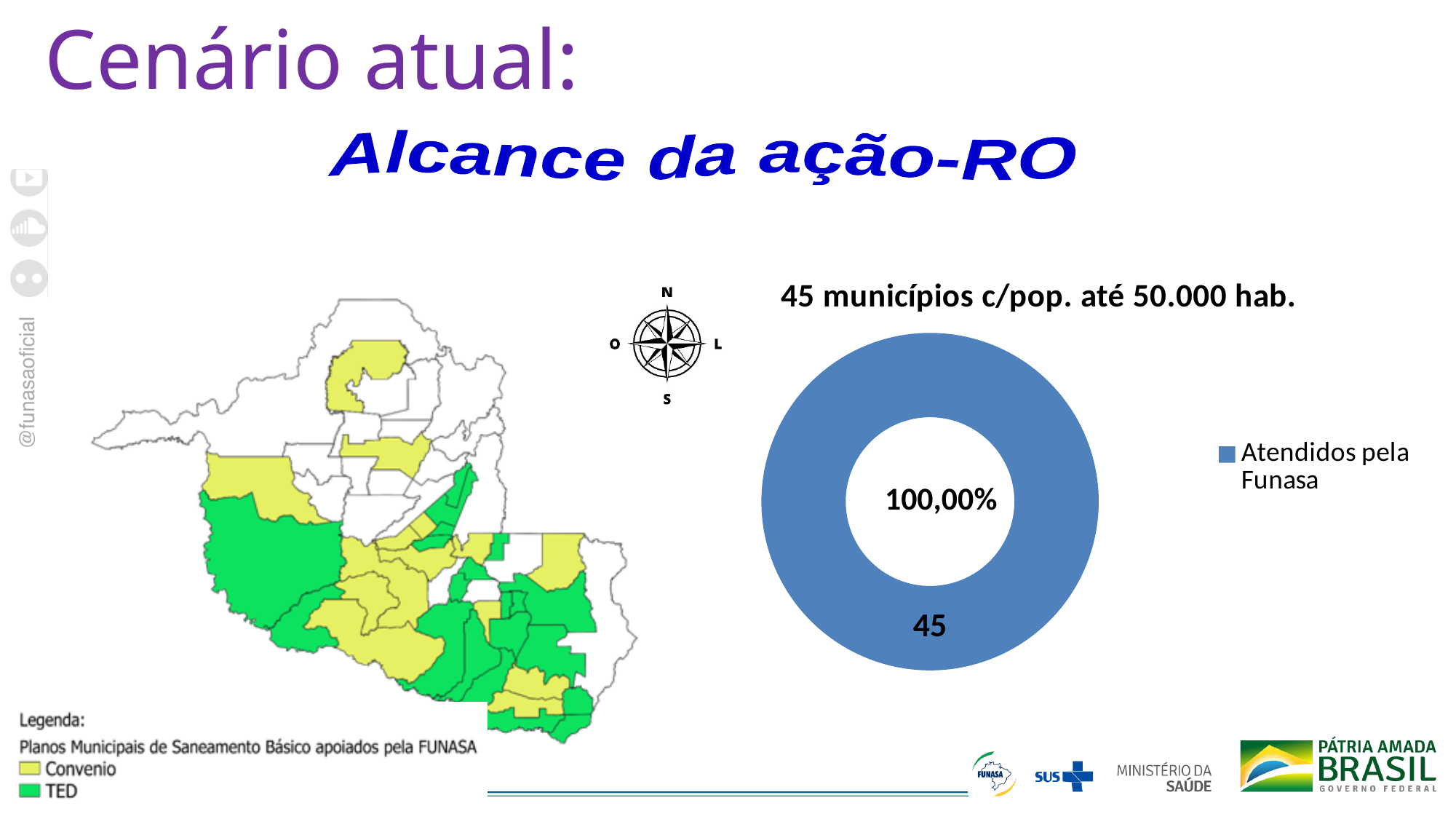
How many slices does the doughnut chart have? 1 What share of the doughnut chart does Atendidos pela Funasa represent? 100,00% What is the legend entry of the doughnut chart? Atendidos pela Funasa Is the value for Atendidos pela Funasa in the doughnut chart greater or less than 40? greater What kind of chart is shown on the right of the slide? Doughnut chart What is the title of the doughnut chart? 45 municípios c/pop. até 50.000 hab. How many entries does the legend of the doughnut chart list? 1 What value is shown for Atendidos pela Funasa in the doughnut chart? 45